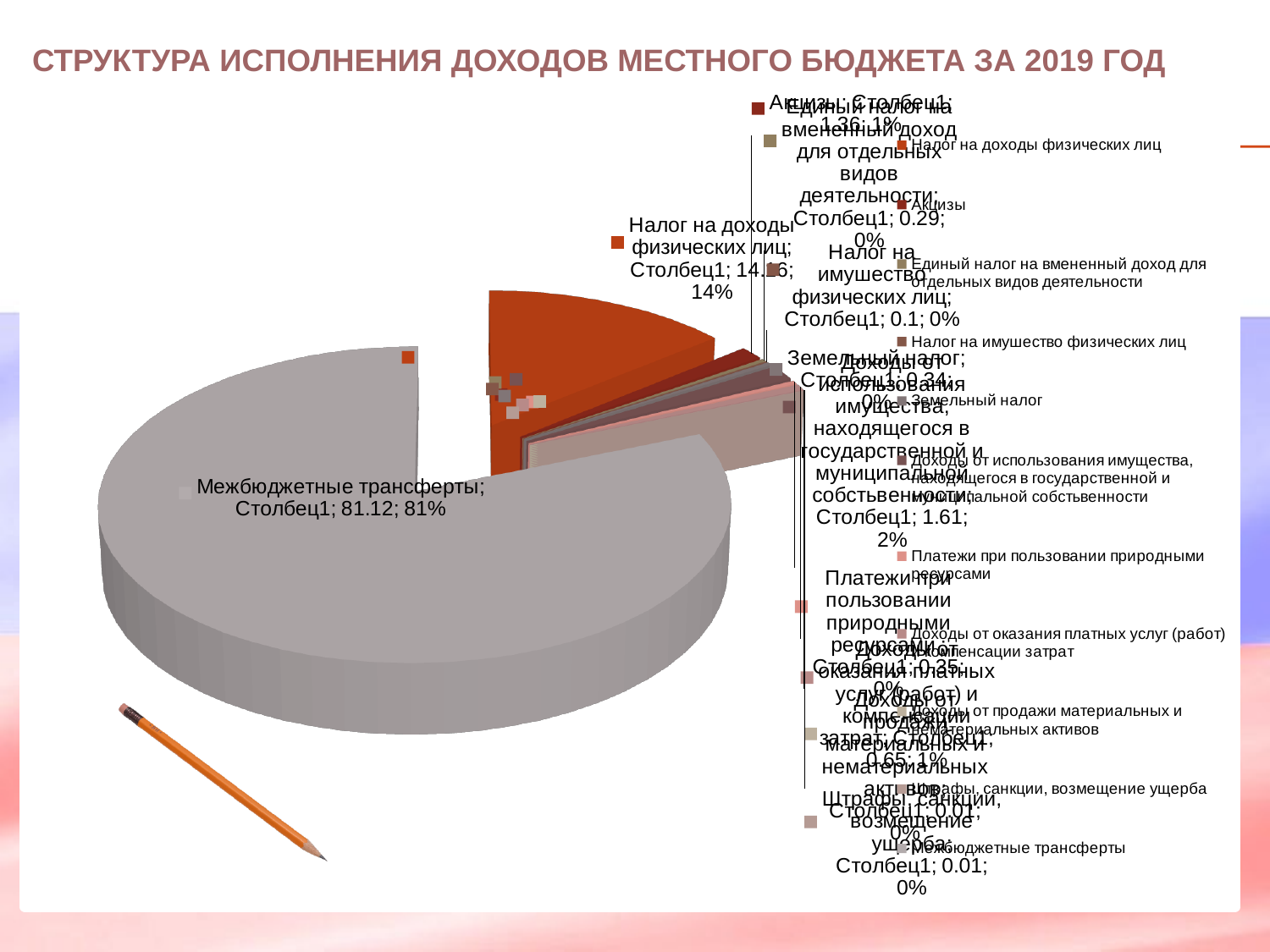
What share of the pie does Доходы от использования имущества, находящегося в государственной и муниципальной собственности account for? 2% What share of the pie does Межбюджетные трансферты account for? 81% What kind of chart is shown on the slide? Pie chart How many categories does the legend list? 11 Which is larger, the value for Акцизы or the value for Земельный налог? Акцизы What is the value shown for Акцизы? 1.36 What is the value shown for Налог на имущество физических лиц? 0.1 What share of the pie does Налог на доходы физических лиц account for? 14% What is the value shown for Межбюджетные трансферты? 81.12 What is the value shown for Земельный налог? 0.34 What is the title of the chart on the slide? СТРУКТУРА ИСПОЛНЕНИЯ ДОХОДОВ МЕСТНОГО БЮДЖЕТА ЗА 2019 ГОД Which category has the largest slice of the pie? Межбюджетные трансферты